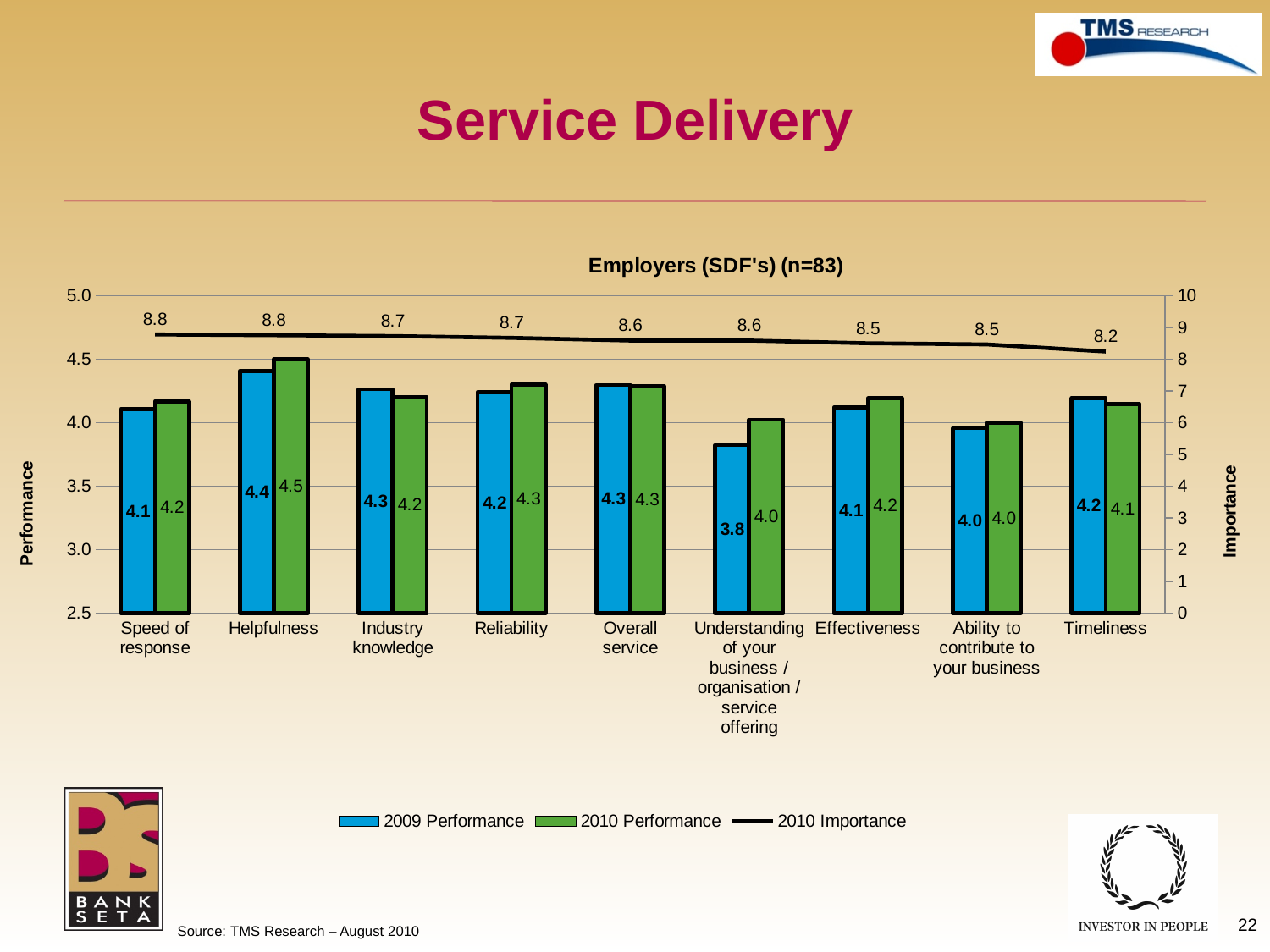
Which category has the lowest 2009 Performance value? Understanding of your business / organisation / service offering Which category has the lowest 2010 Importance value? Timeliness How many series does the legend list? 3 What is the difference between the 2010 Performance and 2009 Performance values for Understanding of your business / organisation / service offering? 0.2 What is the 2010 Performance value for Helpfulness? 4.5 What is the title of the chart? Employers (SDF's) (n=83) What is the 2010 Importance value for Timeliness? 8.2 Does the 2010 Importance line rise or fall from Speed of response to Timeliness? fall How many categories are shown on the x axis? 9 What is the 2009 Performance value for Effectiveness? 4.1 Which category has the highest 2010 Performance value? Helpfulness For Timeliness, which is larger: the 2009 Performance value or the 2010 Performance value? 2009 Performance